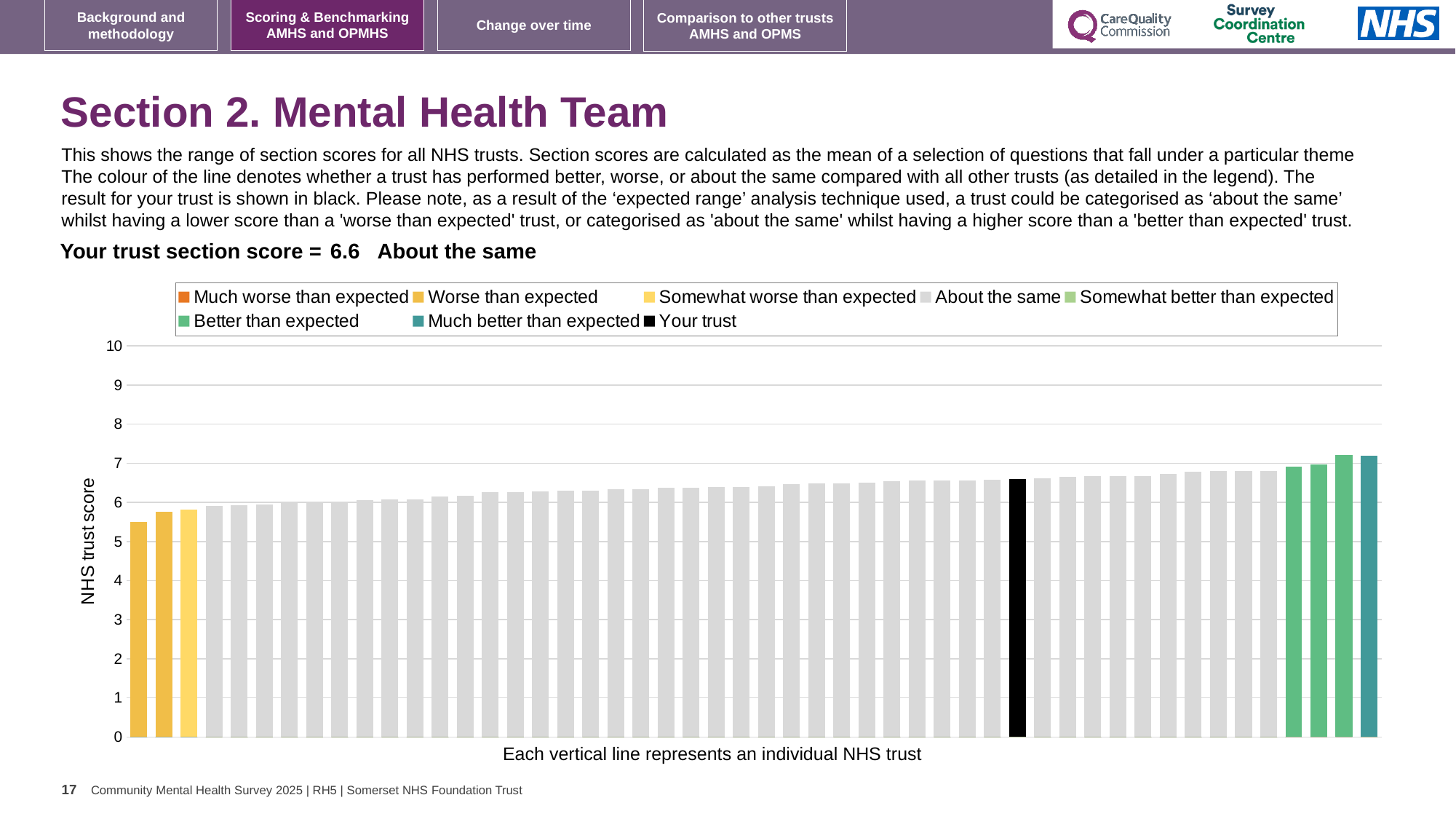
What is the section score for your trust shown on the slide? 6.6 Is the value of the tallest bar greater or less than 8? less What colour is the bar representing your trust? black Which category is your trust's section score placed in? About the same What is the label on the vertical axis of the chart? NHS trust score How many bars are coloured yellow at the left of the chart? 3 Do the bar values rise or fall from left to right along the x axis? rise Is the value of the leftmost bar greater or less than 6? less Is the value for your trust (the black bar) greater or less than 6? greater What kind of chart is shown on the slide? bar chart Is the black bar for your trust higher or lower than the leftmost bar? higher How many entries does the chart legend list? 8